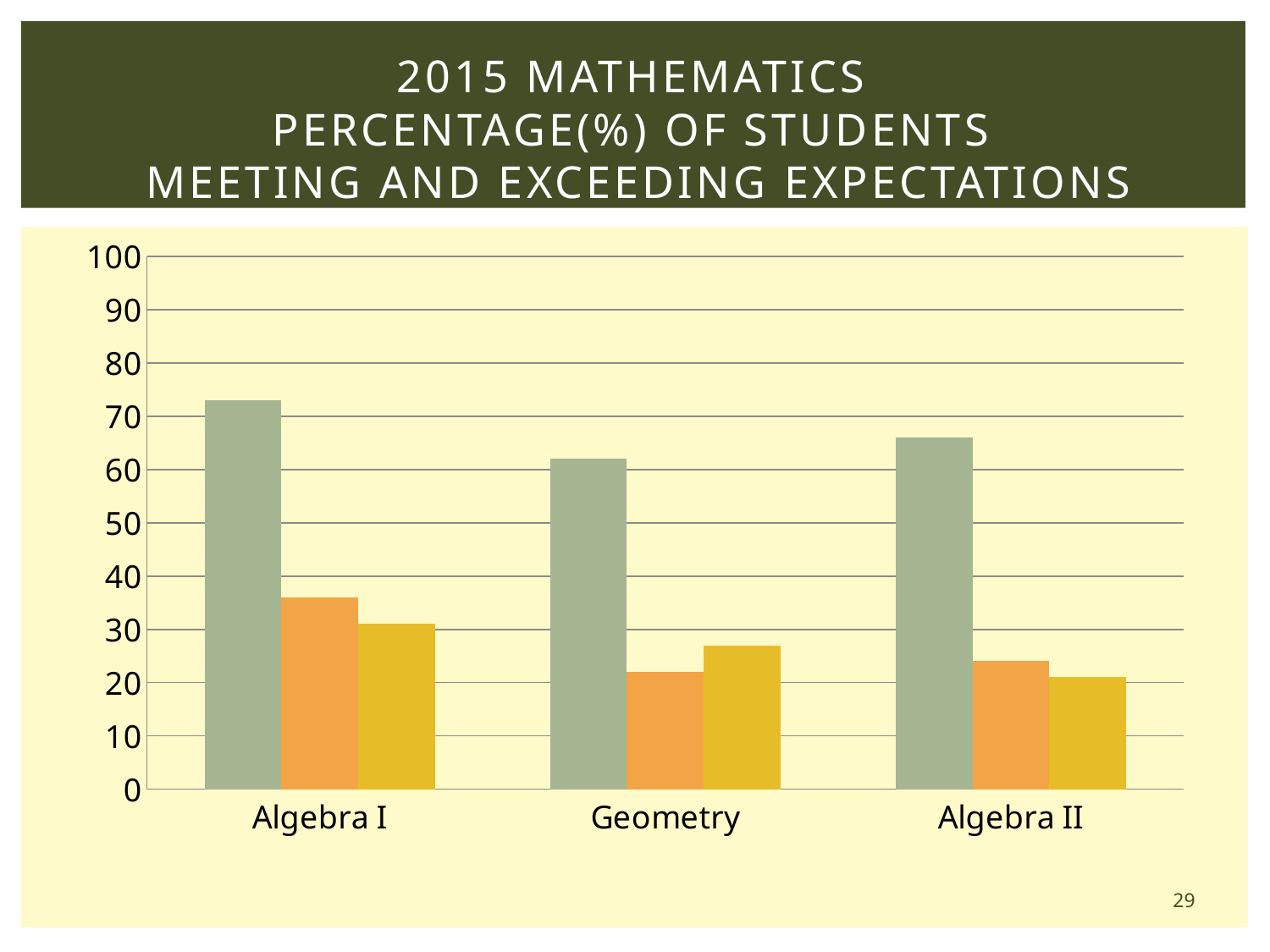
Is the grey bar for Algebra I greater or less than 70? greater Is the orange bar for Algebra I greater or less than 30? greater Which is taller, the grey bar for Geometry or the grey bar for Algebra II? Algebra II What kind of chart is shown on the slide? bar chart How many categories are shown on the x axis? 3 How many bars are shown for each category? 3 Is the grey bar for Algebra II greater or less than 60? greater Which category has the tallest grey bar? Algebra I Which is taller for Geometry, the orange bar or the yellow bar? the yellow bar Which category has the shortest grey bar? Geometry